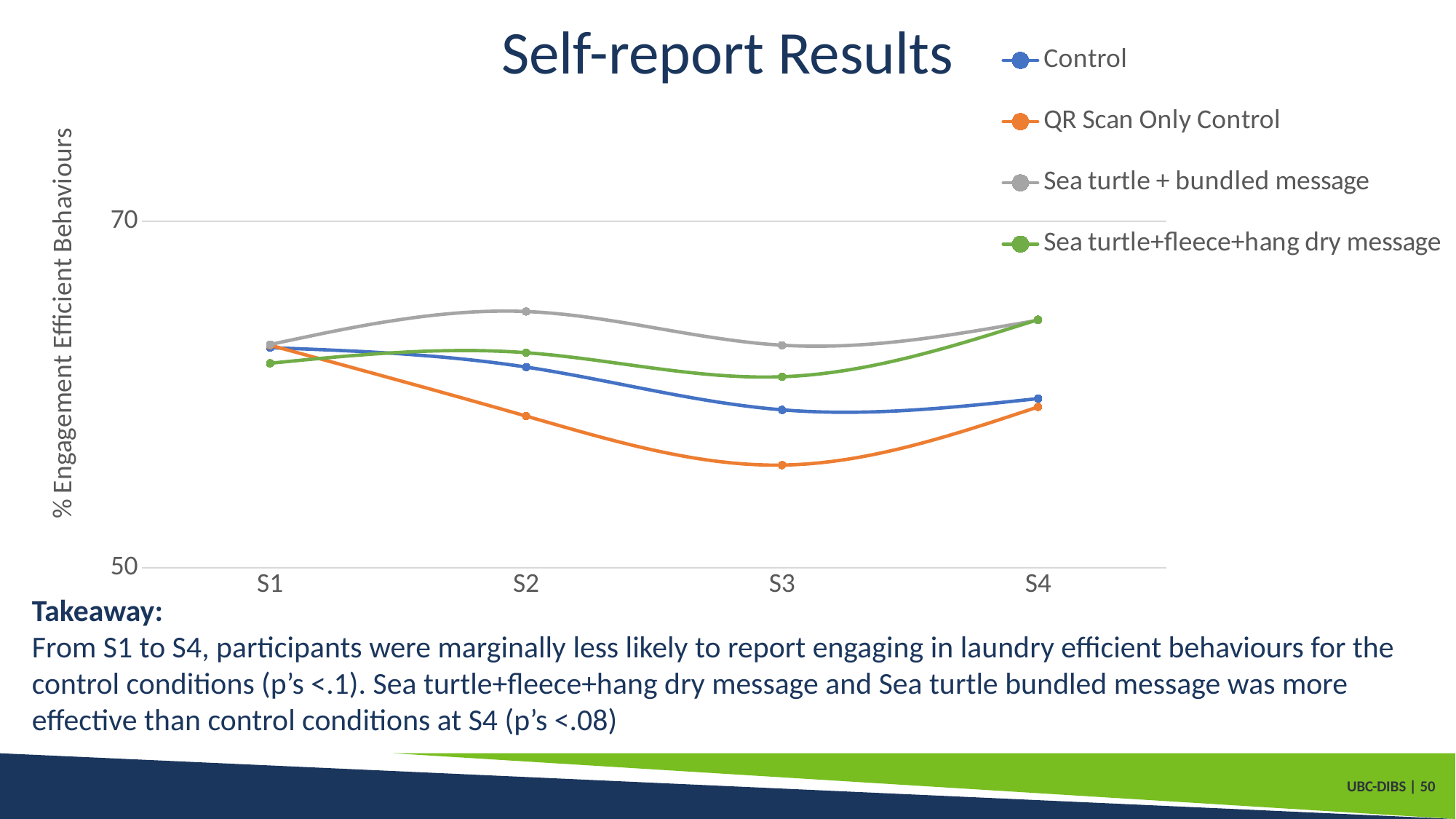
What kind of chart is shown on the slide? Line chart How many time points are shown on the x axis? 4 At S2, which is larger: Sea turtle + bundled message or Control? Sea turtle + bundled message Is the value for QR Scan Only Control at S3 greater or less than 70? less How many series does the legend list? 4 Is the value for Sea turtle + bundled message at S2 greater or less than 50? greater At S3, which is larger: Control or QR Scan Only Control? Control Does the QR Scan Only Control series rise or fall from S1 to S3? Fall What is the label on the y axis? % Engagement Efficient Behaviours Which series has the lowest value at S3? QR Scan Only Control Which series has the highest value at S2? Sea turtle + bundled message What is the title of the chart? Self-report Results